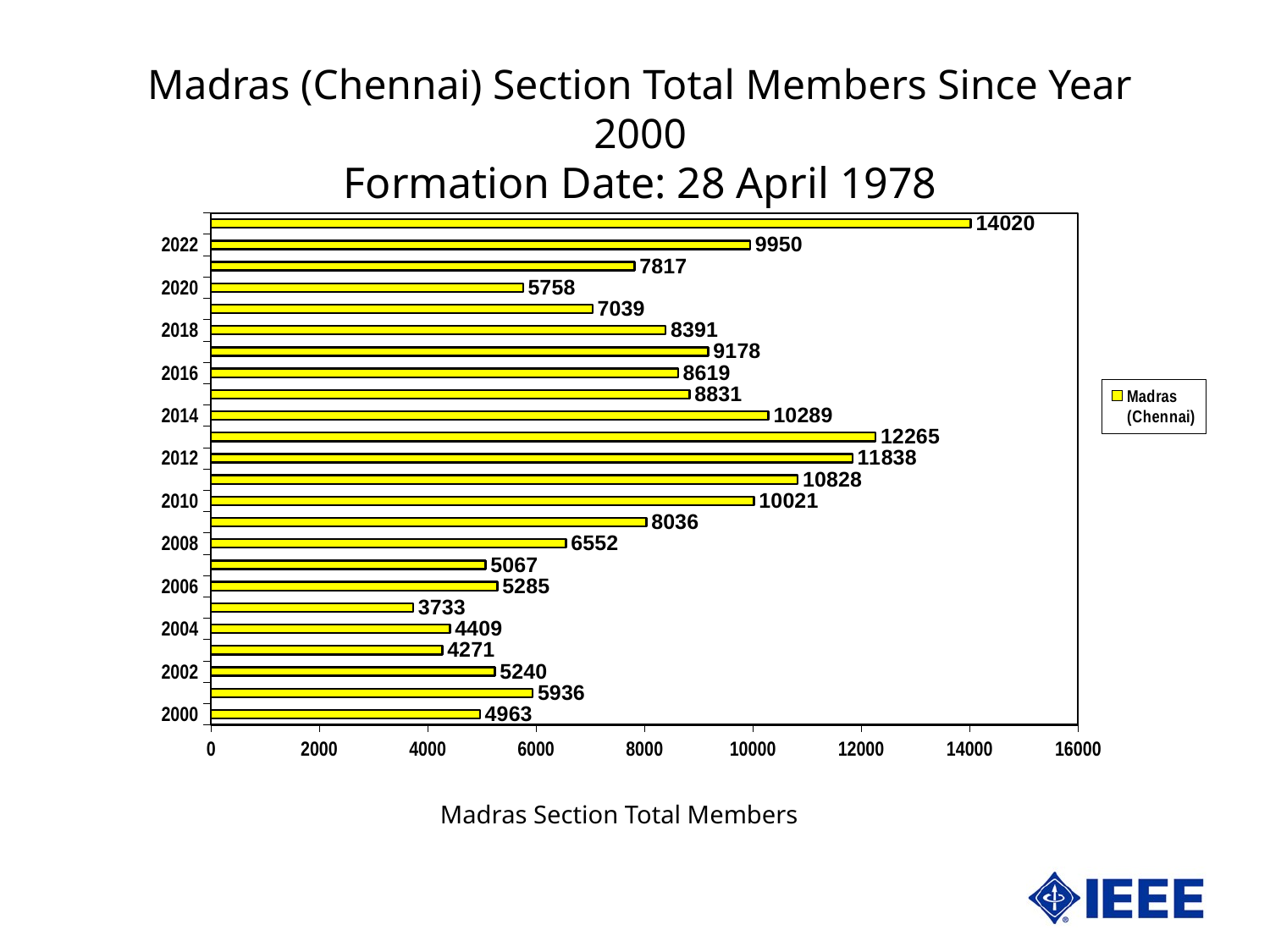
How many bars are plotted on the chart? 24 What is the total members value for 2000? 4963 What is the difference between the values for 2022 and 2020? 4192 Which year has the larger value, 2014 or 2016? 2014 Is the value for 2018 greater or less than 8000? greater What is the lowest value shown on the chart? 3733 What is the highest value shown on the chart? 14020 How many series does the legend list? 1 What is the total members value for 2022? 9950 What is the total members value for 2010? 10021 What is the difference between the values for 2012 and 2010? 1817 What kind of chart is shown on the slide? bar chart